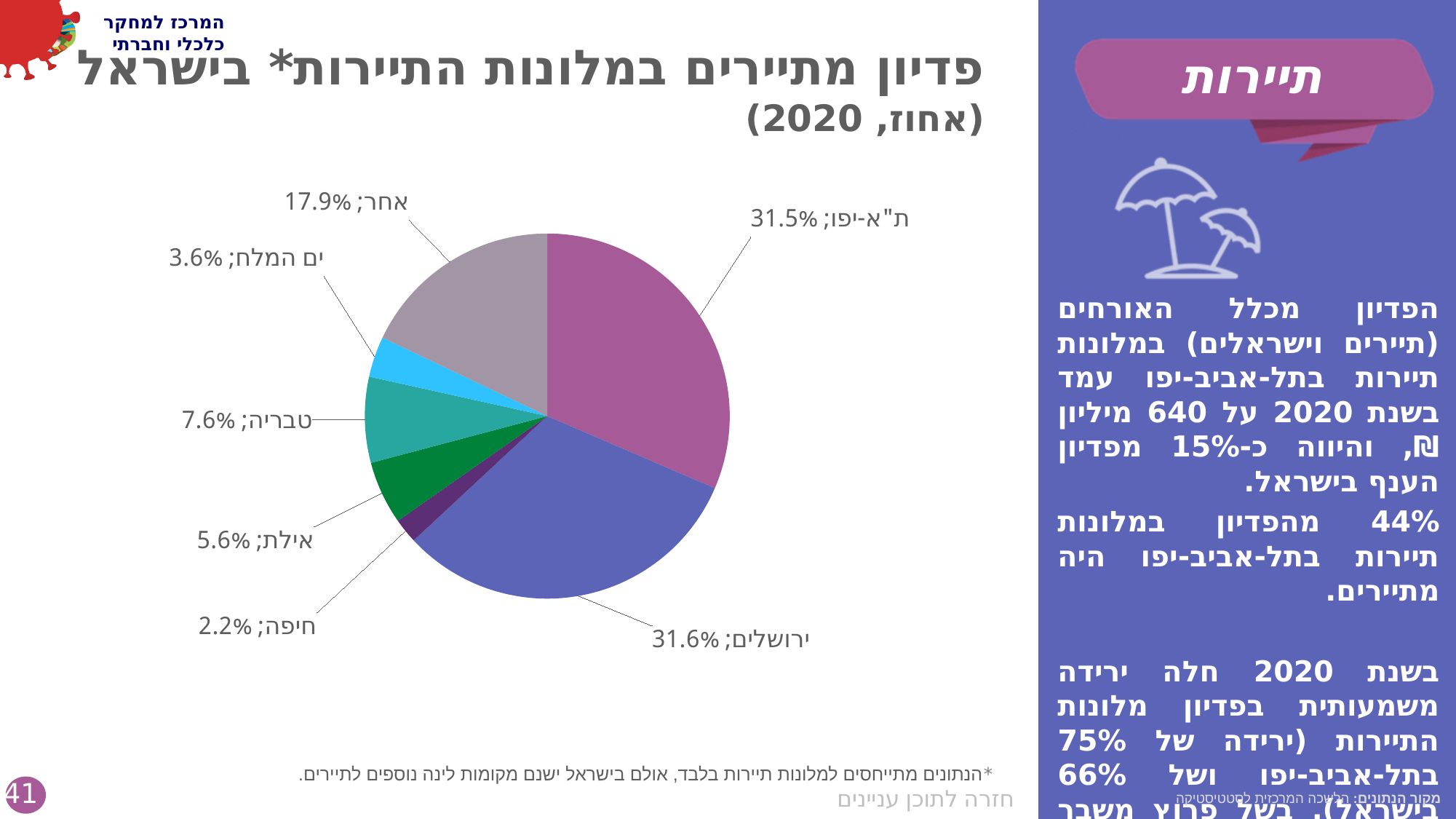
What is the value shown for אחר? 17.9% What is the difference between the values for אילת and חיפה? 3.4% What is the value shown for ים המלח? 3.6% What is the value shown for טבריה? 7.6% What is the value shown for ירושלים? 31.6% What is the combined share of ת"א-יפו and ירושלים? 63.1% Which is larger, the slice for אילת or the slice for טבריה? טבריה Which category has the smallest slice of the pie? חיפה What share of the pie does ת"א-יפו hold? 31.5% How many categories (slices) does the pie chart have? 7 What is the difference between the values for אחר and טבריה? 10.3% What kind of chart is shown on the slide? pie chart